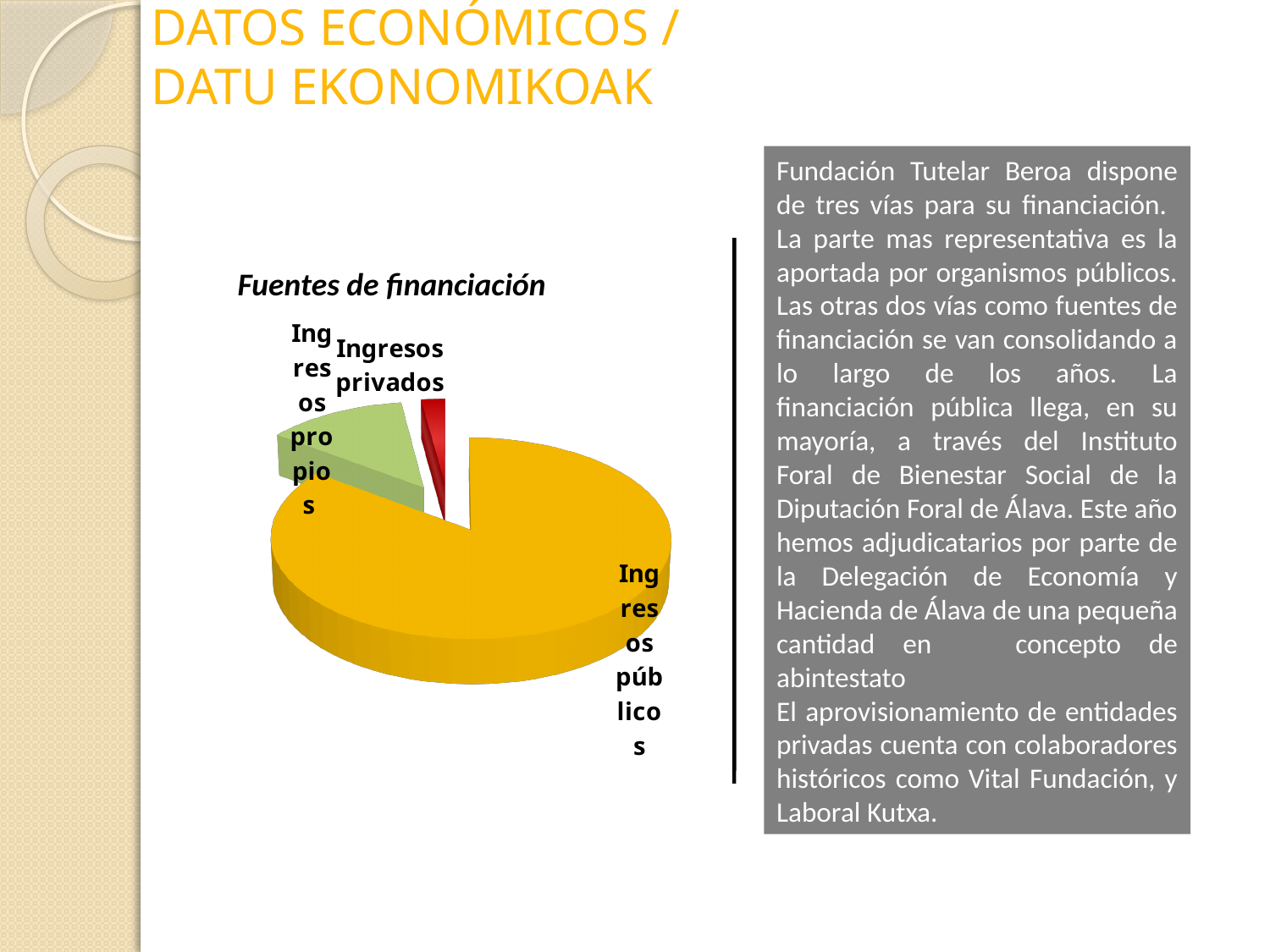
Which is larger, the slice for Ingresos propios or the slice for Ingresos privados? Ingresos propios Which category has the smallest slice of the pie? Ingresos privados Does the slice for Ingresos públicos make up more or less than half of the pie? More Which category has the largest slice of the pie? Ingresos públicos How many slices does the pie chart have? 3 What kind of chart is shown on the slide? Pie chart Which is larger, the slice for Ingresos públicos or the slice for Ingresos propios? Ingresos públicos What colour is the slice for Ingresos públicos? Yellow What is the title of the chart? Fuentes de financiación